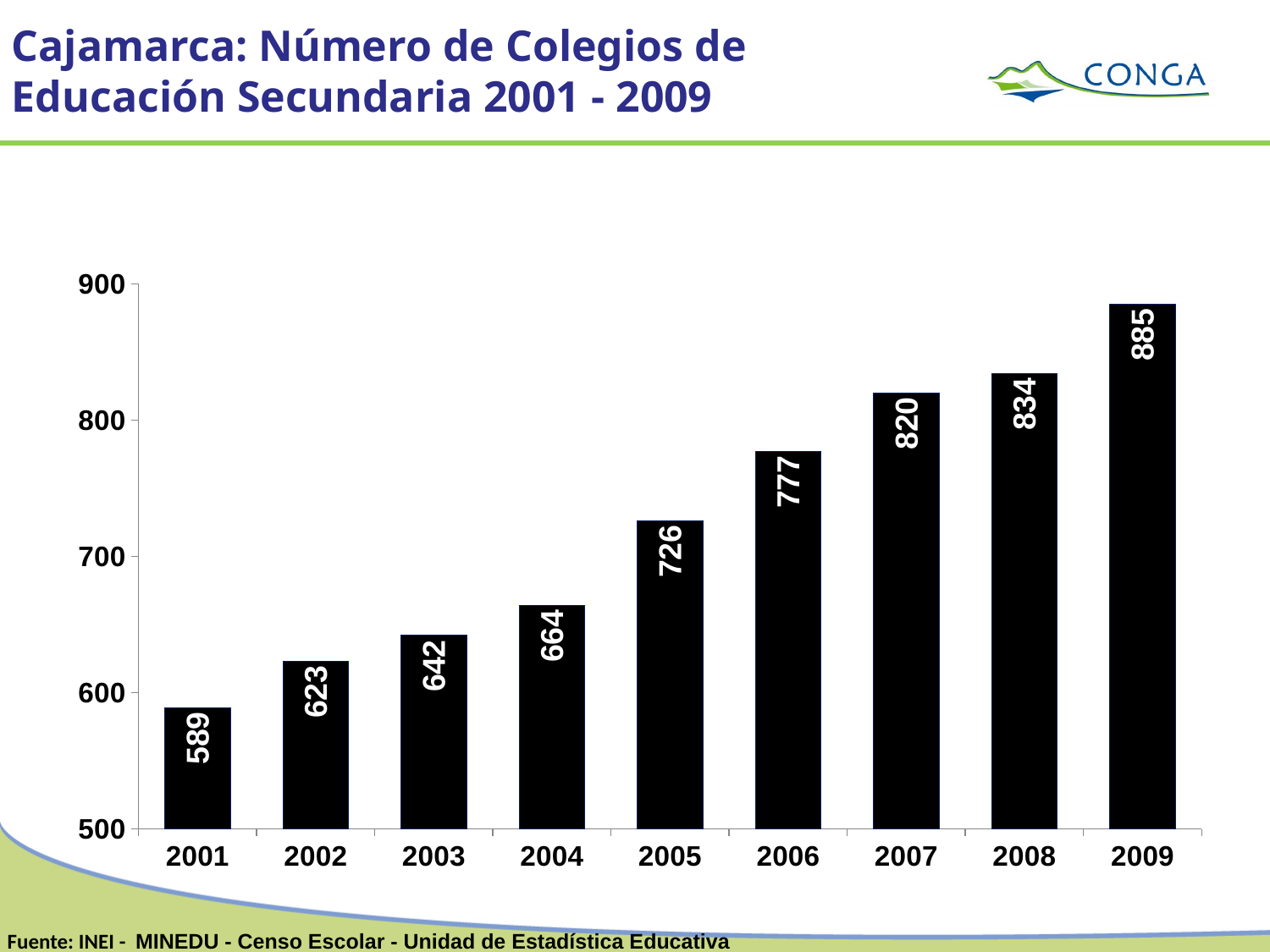
What kind of chart is shown on the slide? bar chart Is the value for 2006 greater or less than 800? less Which year has the lowest number of secondary schools? 2001 What is the difference between the values for 2009 and 2001? 296 What is the value shown for 2005? 726 What is the value shown for 2008? 834 What is the number of secondary schools in Cajamarca in 2001? 589 Do the values rise or fall from 2001 to 2009? rise How many years are shown on the x axis? 9 Which year has the highest number of secondary schools? 2009 What is the difference between the values for 2006 and 2005? 51 Which is larger, the value for 2004 or the value for 2007? 2007